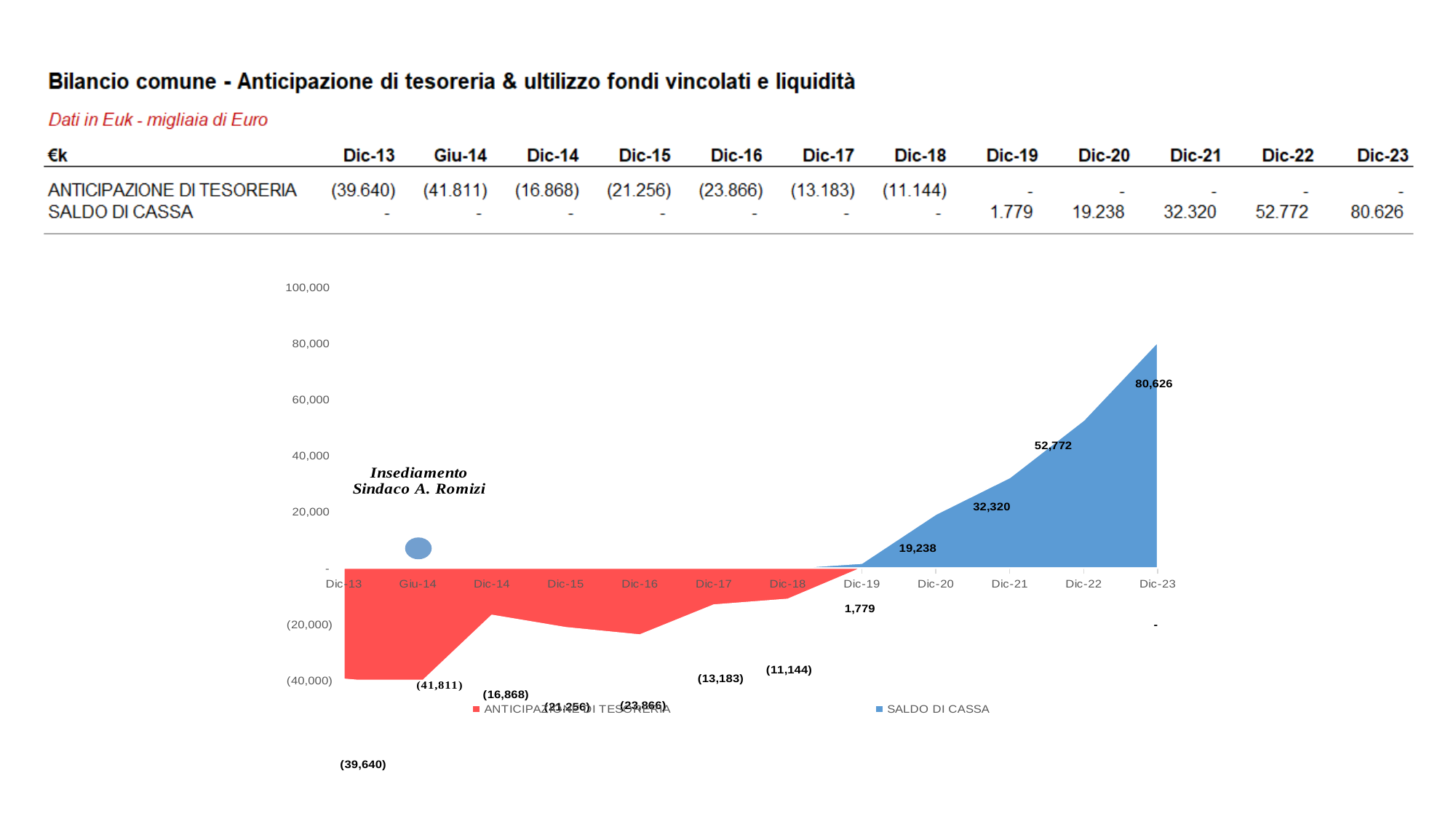
How many series does the chart legend list? 2 At which time point does SALDO DI CASSA reach its highest value? Dic-23 At which time point is the ANTICIPAZIONE DI TESORERIA most negative? Giu-14 What kind of chart is shown on the slide? Area chart Which colour represents SALDO DI CASSA in the chart? Blue What is the value of SALDO DI CASSA at Dic-20 on the chart? 19,238 What is the difference between SALDO DI CASSA at Dic-23 and at Dic-22? 27,854 What is the value of SALDO DI CASSA at Dic-23 on the chart? 80,626 Which is larger in absolute terms: ANTICIPAZIONE DI TESORERIA at Dic-16 or at Dic-17? Dic-16 What is the value of ANTICIPAZIONE DI TESORERIA at Giu-14 on the chart? (41,811) Does SALDO DI CASSA rise or fall from Dic-19 to Dic-23? Rise How many time points are plotted along the x axis of the chart? 12